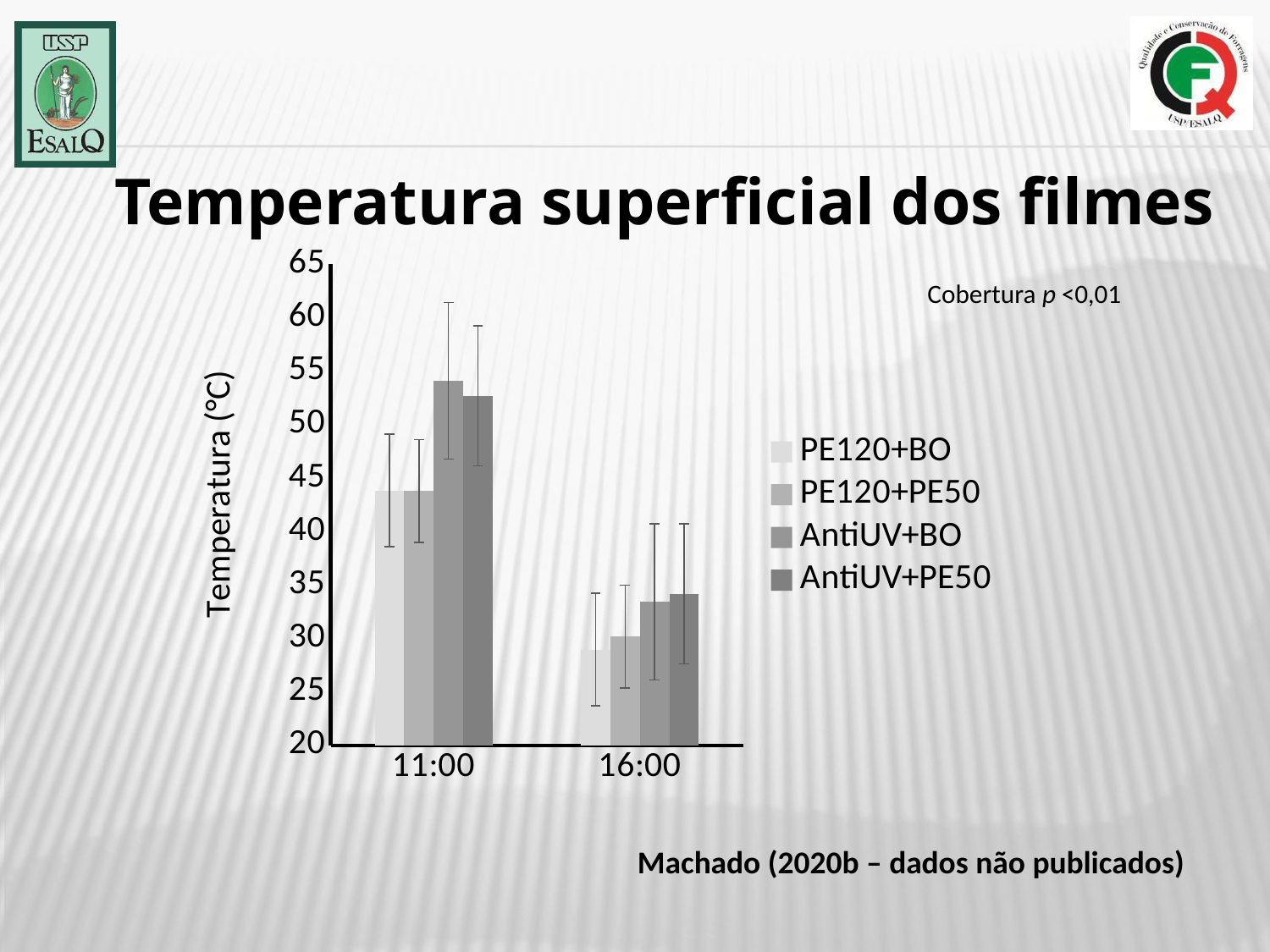
Is the value for AntiUV+PE50 at 16:00 greater or less than 40? less What is the label of the y axis? Temperatura (°C) How many time categories are shown on the x axis? 2 Is the value for AntiUV+PE50 at 11:00 greater or less than 45? greater Is the value for AntiUV+BO at 11:00 greater or less than 50? greater What kind of chart is shown on the slide? bar chart Do the temperatures rise or fall from 11:00 to 16:00? fall Which is larger at 11:00, PE120+BO or AntiUV+BO? AntiUV+BO Which is larger, the AntiUV+BO value at 11:00 or at 16:00? 11:00 How many series does the legend list? 4